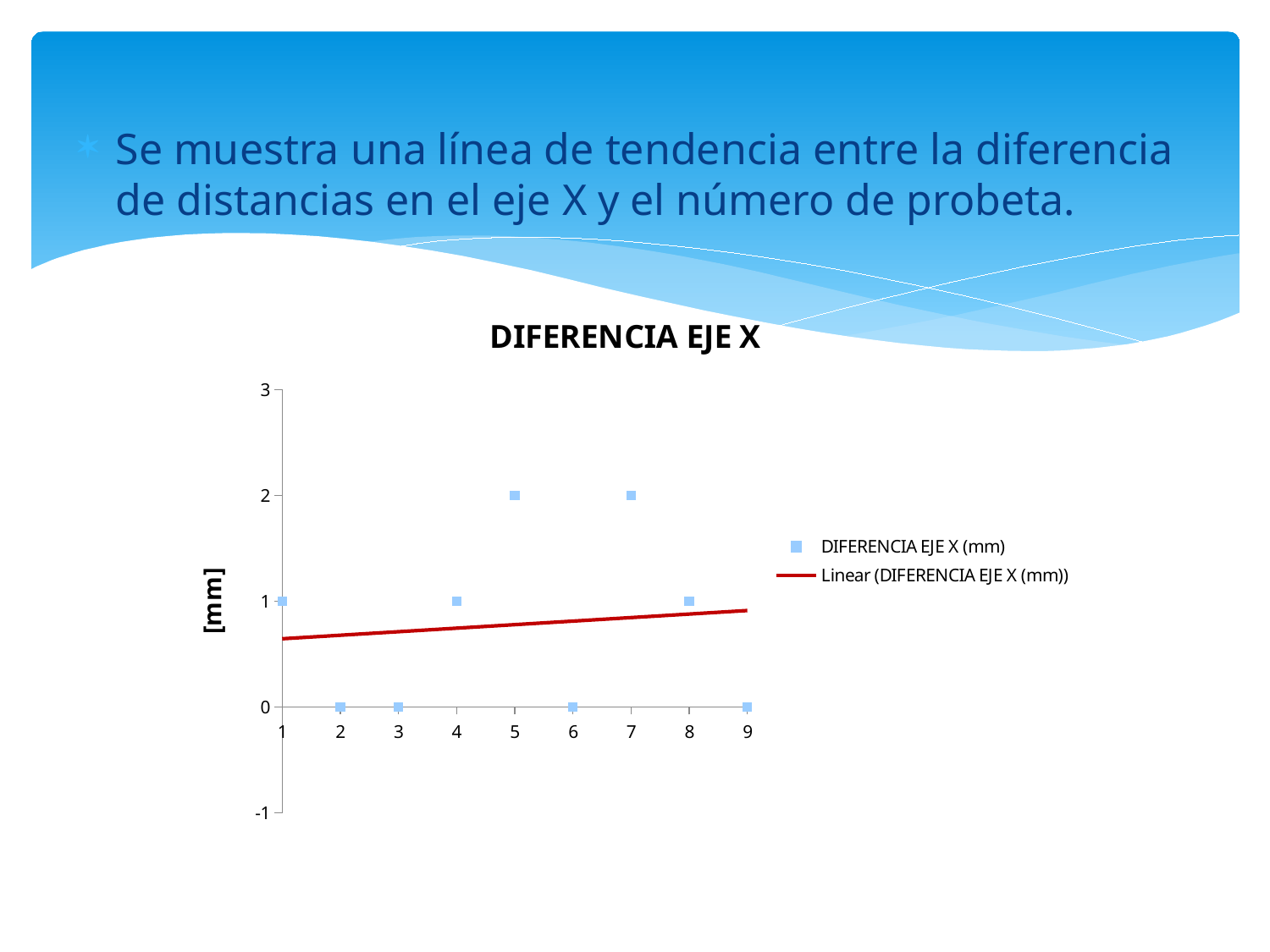
What is the highest value reached by the DIFERENCIA EJE X (mm) points? 2 What is the lowest value reached by the DIFERENCIA EJE X (mm) points? 0 What is the difference between the values at probeta 7 and probeta 8? 1 What is the value of DIFERENCIA EJE X (mm) at probeta 5? 2 How many data points are plotted for DIFERENCIA EJE X (mm)? 9 What is the title of the chart? DIFERENCIA EJE X Which has a larger value, probeta 4 or probeta 5? probeta 5 How many entries does the chart legend list? 2 What is the value of DIFERENCIA EJE X (mm) at probeta 1? 1 What is the value of DIFERENCIA EJE X (mm) at probeta 6? 0 What kind of chart is shown on the slide? scatter chart Does the linear trendline rise or fall from left to right? rises